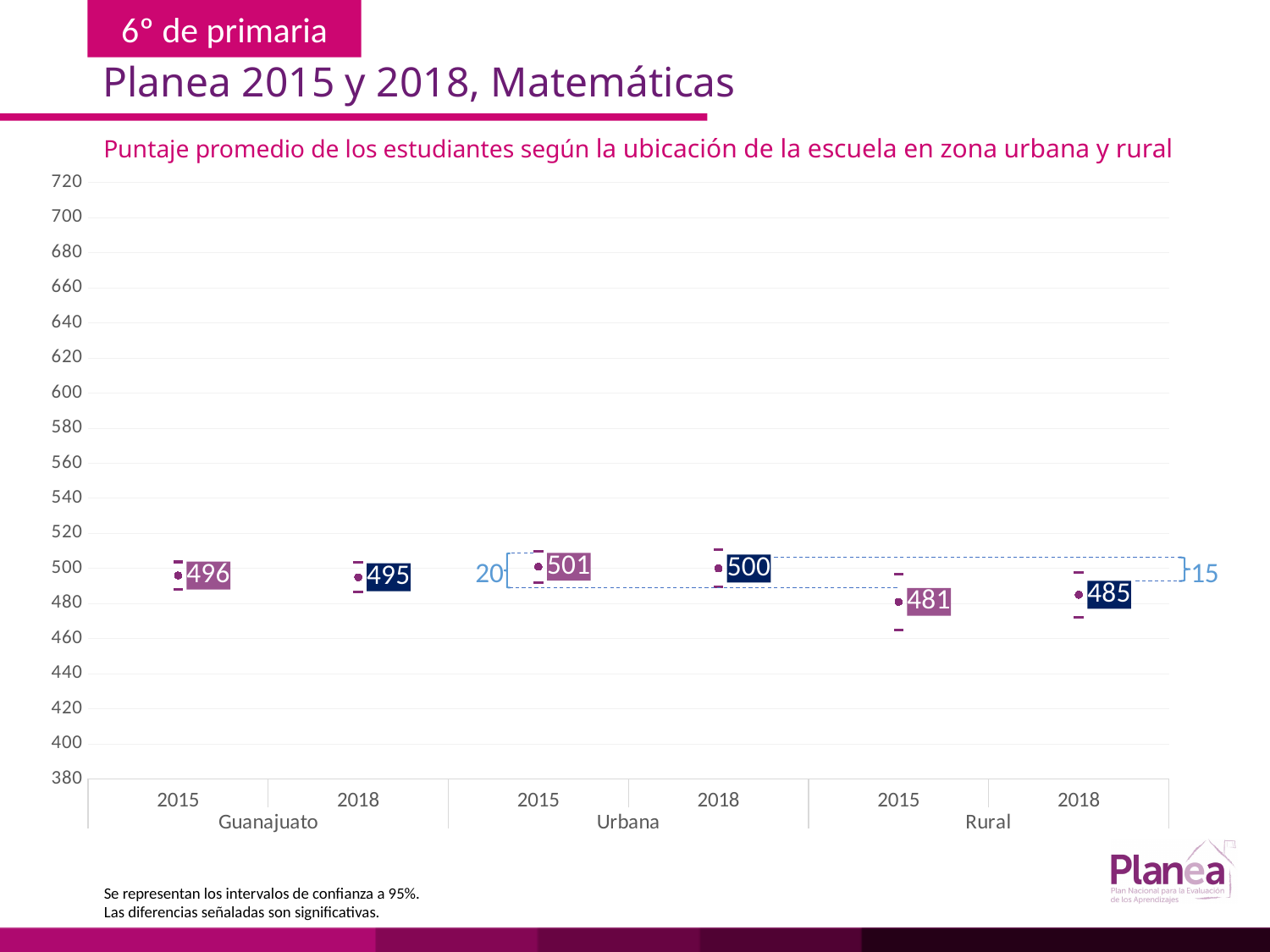
Did the Guanajuato score rise or fall from 2015 to 2018? fall What is the title of the chart? Puntaje promedio de los estudiantes según la ubicación de la escuela en zona urbana y rural What is the average score for Rural schools in 2018? 485 Which group and year has the lowest average score? Rural 2015 How many data points are plotted on the chart? 6 Which group and year has the highest average score? Urbana 2015 Is the value for Rural 2015 greater or less than 500? less What is the difference between the Urbana 2018 score and the Rural 2018 score? 15 What is the average score for Guanajuato in 2015? 496 What is the difference between the Urbana 2015 score and the Rural 2015 score? 20 What is the average score for Urbana schools in 2015? 501 Which is larger, the Rural 2015 score or the Rural 2018 score? Rural 2018